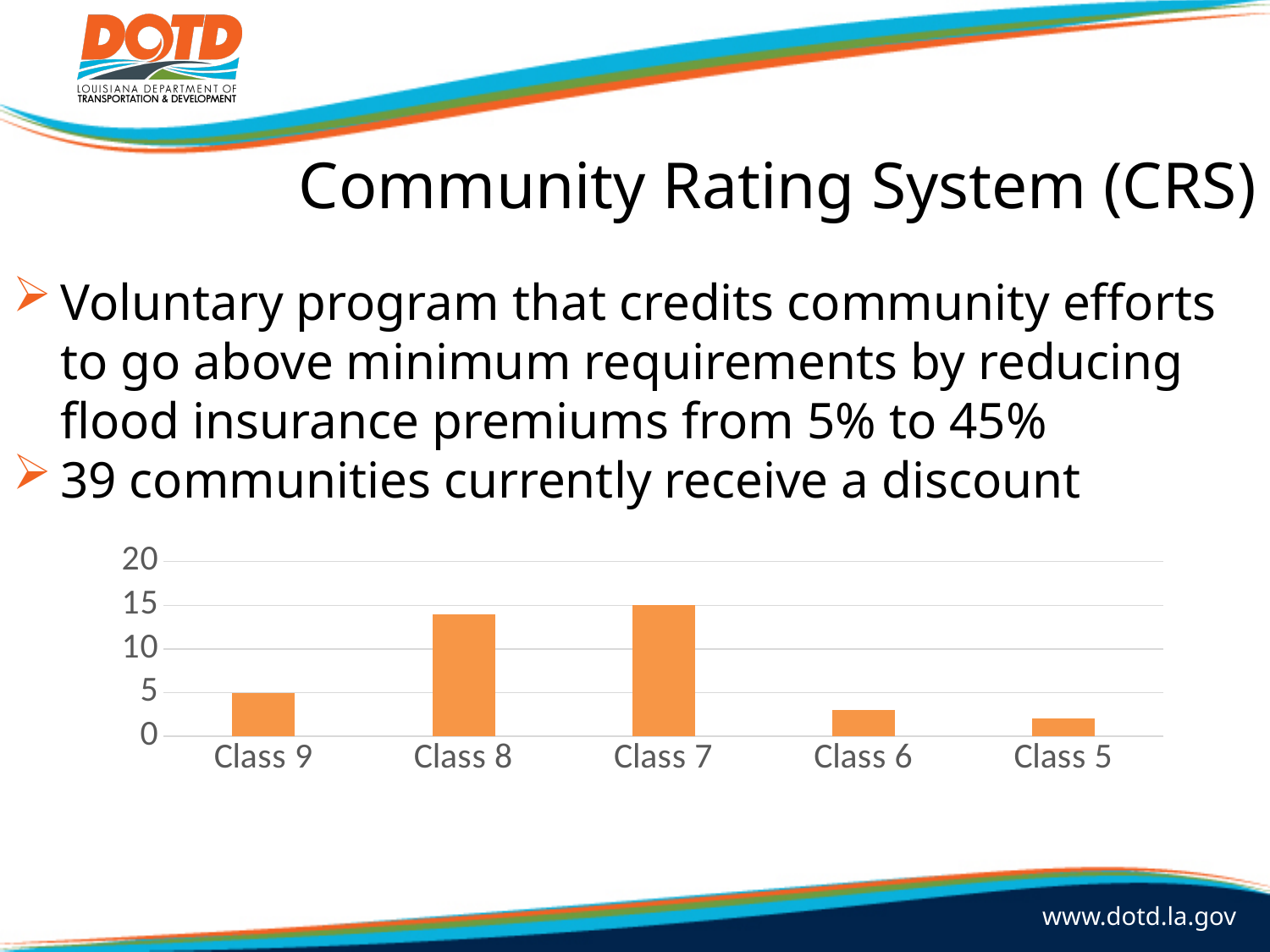
What type of chart is shown on the slide? bar chart How many classes are shown on the x axis of the chart? 5 Is the value for Class 8 greater or less than 10? greater What is the highest value shown on the y axis of the chart? 20 Is the value for Class 5 greater or less than 5? less What is the value for Class 7 in the chart? 15 What is the value for Class 9 in the chart? 5 What colour are the bars in the chart? orange What is the difference between the values for Class 7 and Class 9? 10 Is the value for Class 6 greater or less than 5? less Which has the larger value, Class 8 or Class 9? Class 8 Which has the larger value, Class 7 or Class 6? Class 7